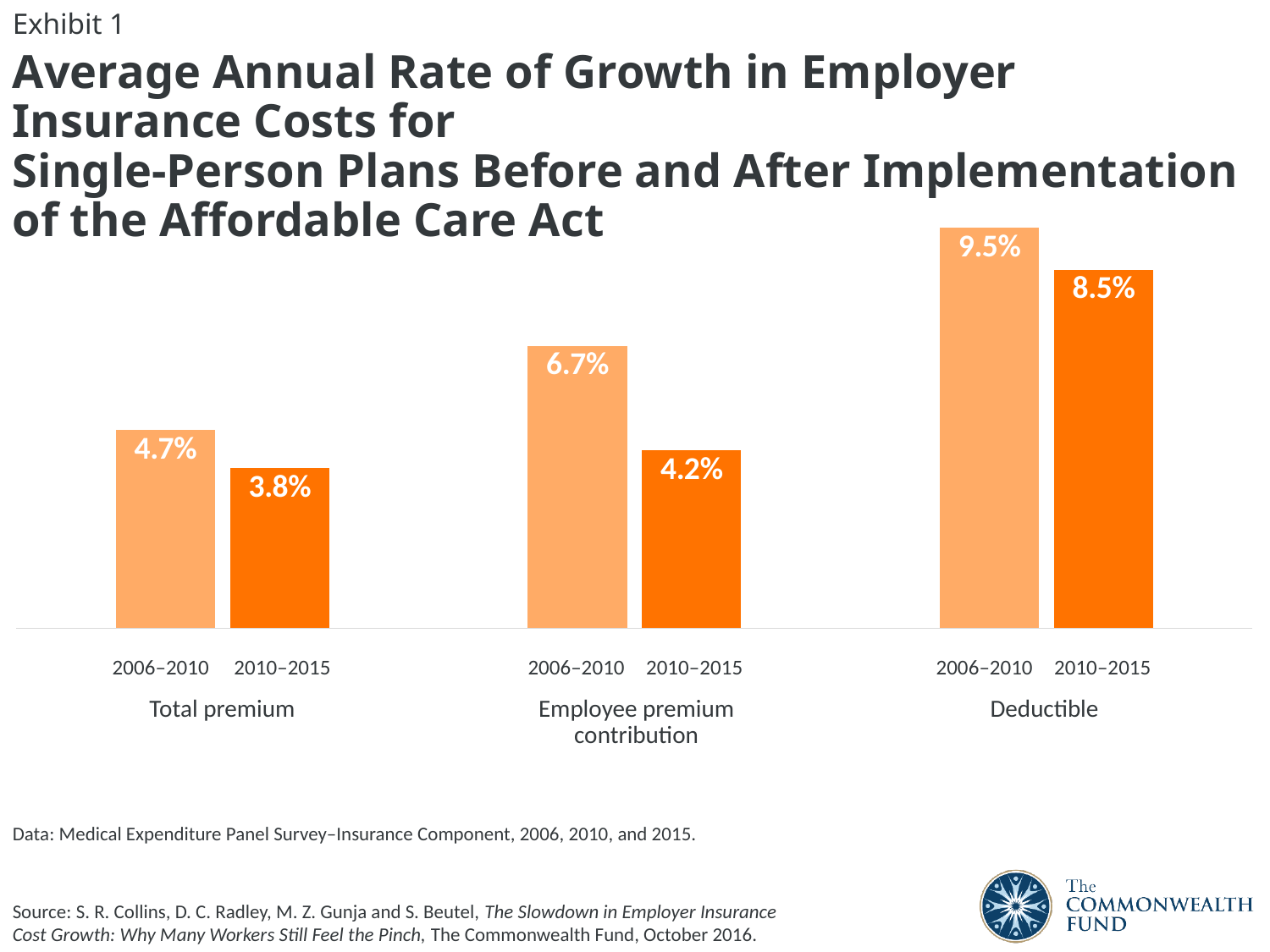
What type of chart is shown on the slide? Bar chart What is the difference between the deductible growth rates for 2006–2010 and 2010–2015? 1.0 percentage point How many cost categories are shown on the chart? 3 Which is larger: the 2010–2015 growth rate for the deductible or the 2006–2010 growth rate for the employee premium contribution? Deductible, 2010–2015 Which bar shows the highest average annual rate of growth? Deductible, 2006–2010 What was the average annual rate of growth in the employee premium contribution for 2006–2010? 6.7% By how many percentage points did the growth rate for the employee premium contribution fall from 2006–2010 to 2010–2015? 2.5 percentage points What was the average annual rate of growth in the total premium for 2010–2015? 3.8% Which bar shows the lowest average annual rate of growth? Total premium, 2010–2015 What was the average annual rate of growth in the total premium for 2006–2010? 4.7% What was the average annual rate of growth in the deductible for 2010–2015? 8.5% Within each cost category, did the growth rate rise or fall from 2006–2010 to 2010–2015? Fall